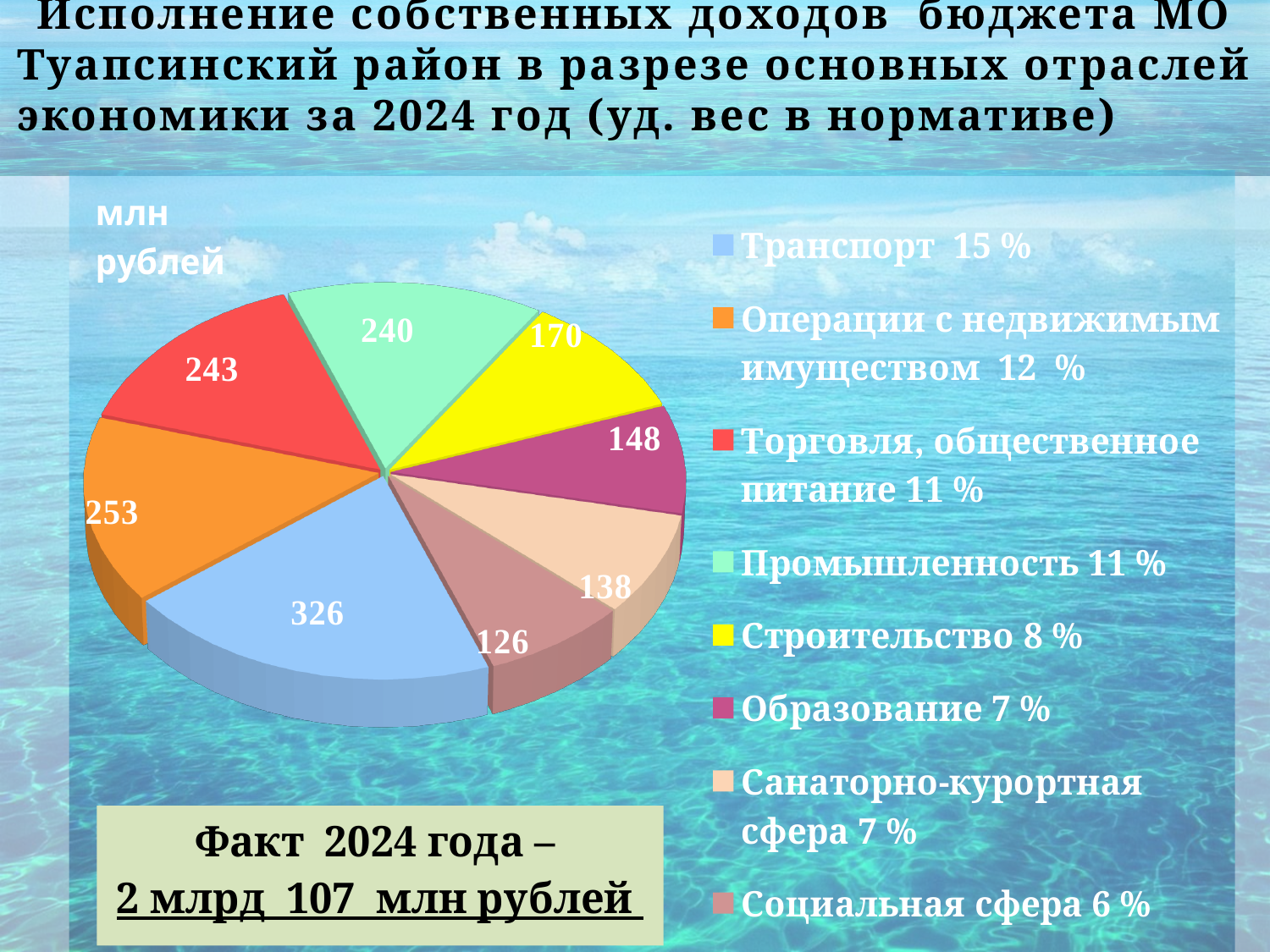
What share of the pie does Операции с недвижимым имуществом represent according to the legend? 12 % How many slices does the pie chart have? 8 Which sector has the smallest slice of the pie? Социальная сфера What is the difference between the values for Транспорт and Социальная сфера? 200 What unit is indicated for the values in the pie chart? млн рублей Which is larger, the value for Торговля, общественное питание or the value for Промышленность? Торговля, общественное питание What is the value (млн рублей) for Операции с недвижимым имуществом? 253 What is the value (млн рублей) for Строительство? 170 Which sector has the largest slice of the pie? Транспорт What is the value (млн рублей) for Образование? 148 What kind of chart is shown on the slide? pie chart What is the value (млн рублей) for Транспорт? 326